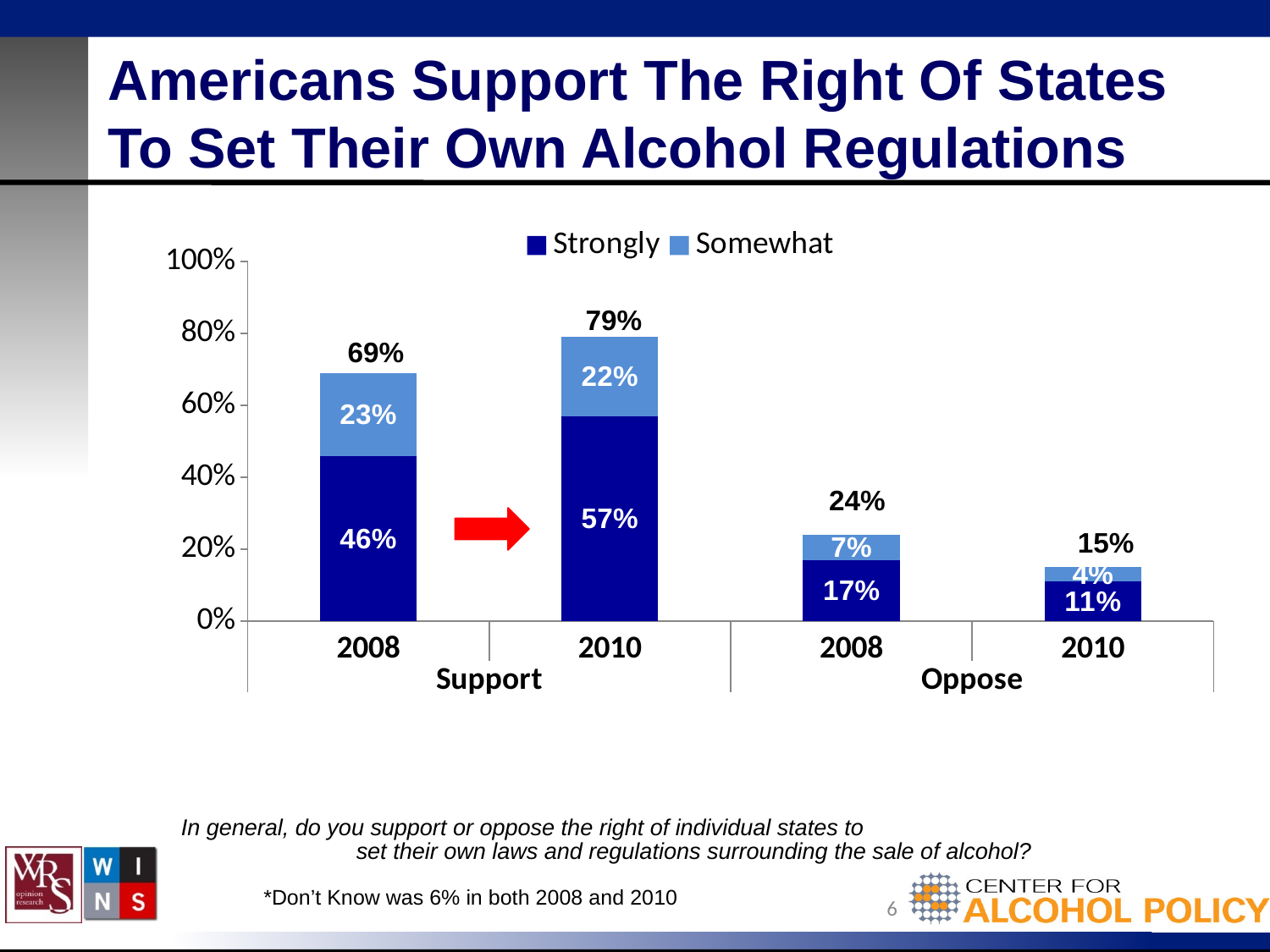
What is the total of the stacked bar for Support in 2010? 79% Which bar has the lowest total? Oppose 2010 What kind of chart is shown on the slide? stacked bar chart Which bar has the highest total? Support 2010 Is the 'Strongly' value for Support in 2008 larger or smaller than the 'Strongly' value for Support in 2010? smaller What is the 'Strongly' value for Oppose in 2008? 17% What is the 'Strongly' value for Support in 2010? 57% What is the difference between the total Support in 2010 and the total Support in 2008? 10% How many series does the legend list? 2 Which series is shown in dark blue in the legend? Strongly What is the 'Somewhat' value for Support in 2008? 23% What is the total of the stacked bar for Oppose in 2010? 15%